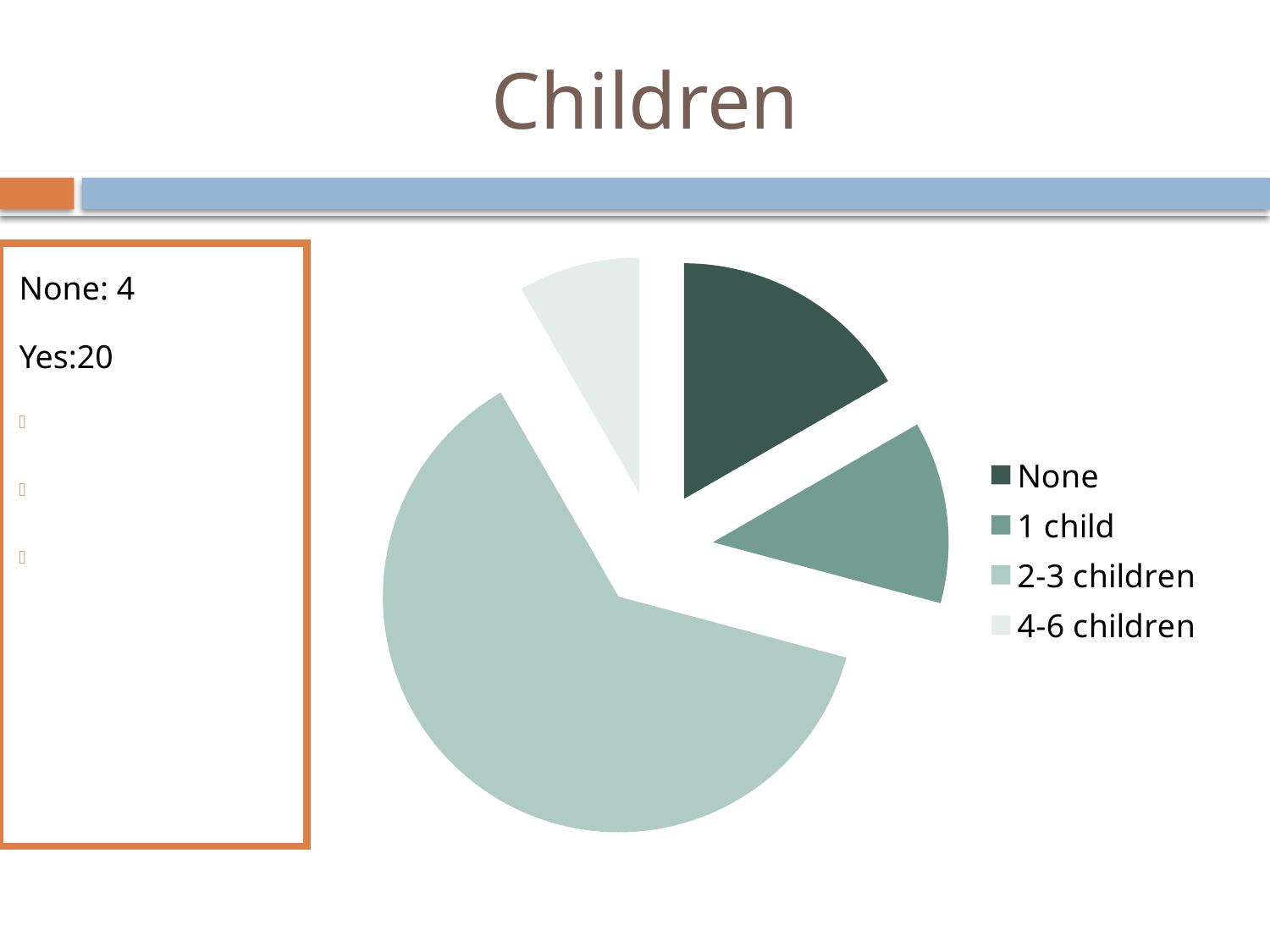
Which category has the largest slice in the pie chart? 2-3 children Does the 2-3 children slice take up more or less than half of the pie chart? more What is the title of the slide containing the pie chart? Children Which legend entry is shown with the darkest green colour in the pie chart? None Which slice is larger in the pie chart, None or 1 child? None How many entries does the legend of the pie chart list? 4 Which category has the smallest slice in the pie chart? 4-6 children Which slice is larger in the pie chart, 1 child or 4-6 children? 1 child Which slice is larger in the pie chart, 2-3 children or None? 2-3 children What kind of chart is shown on the slide? pie chart How many slices does the pie chart have? 4